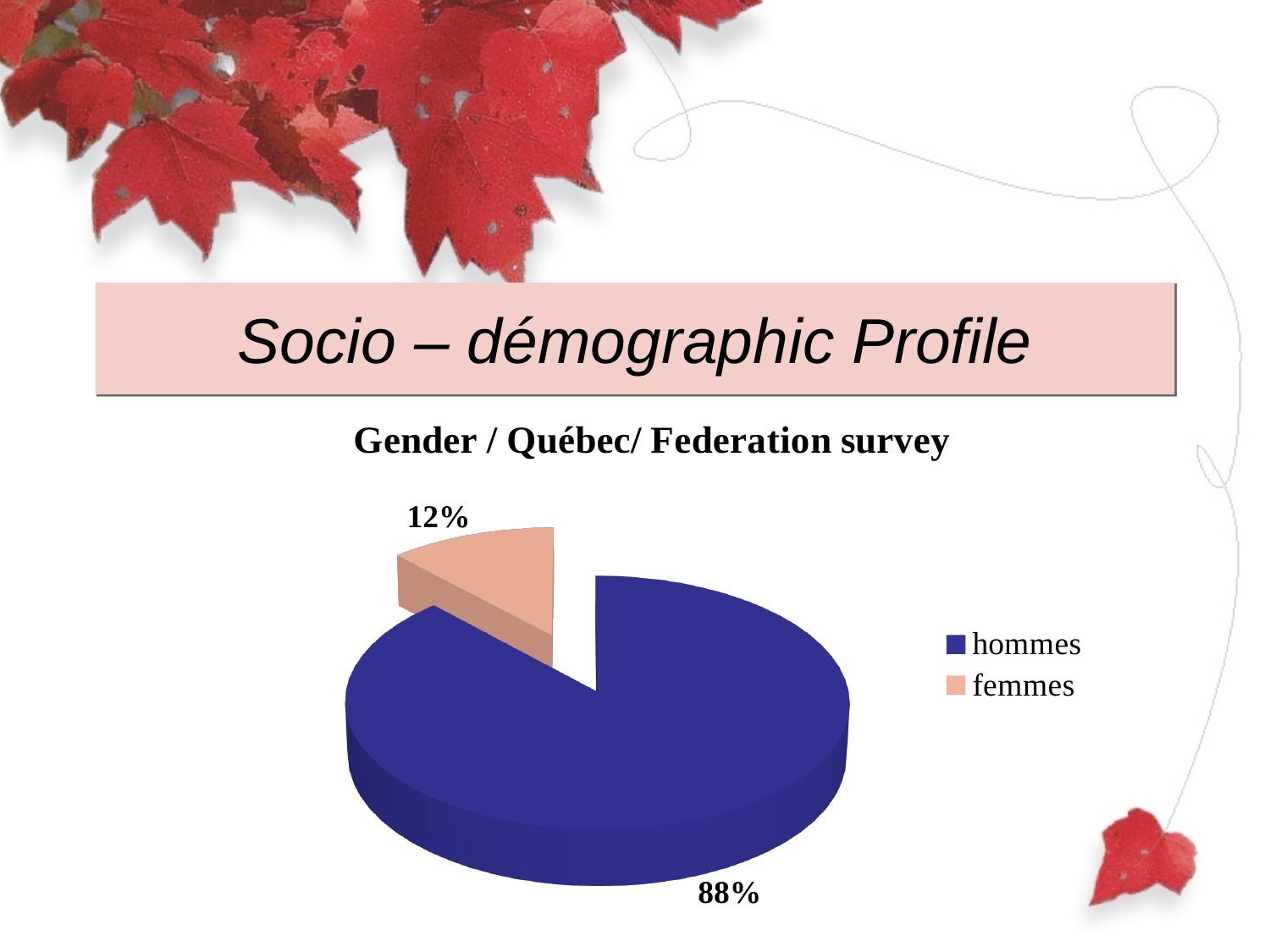
What share of the pie does the femmes slice represent? 12% Which is larger, the hommes slice or the femmes slice? hommes What share of the pie does the hommes slice represent? 88% What is the title of the chart? Gender / Québec/ Federation survey What kind of chart is shown on the slide? pie chart What is the difference in percentage points between the hommes and femmes slices? 76 How many slices does the pie chart have? 2 Which category has the smallest slice of the pie? femmes What colour is the hommes slice in the pie chart? blue How many entries does the legend list? 2 Which category has the largest slice of the pie? hommes